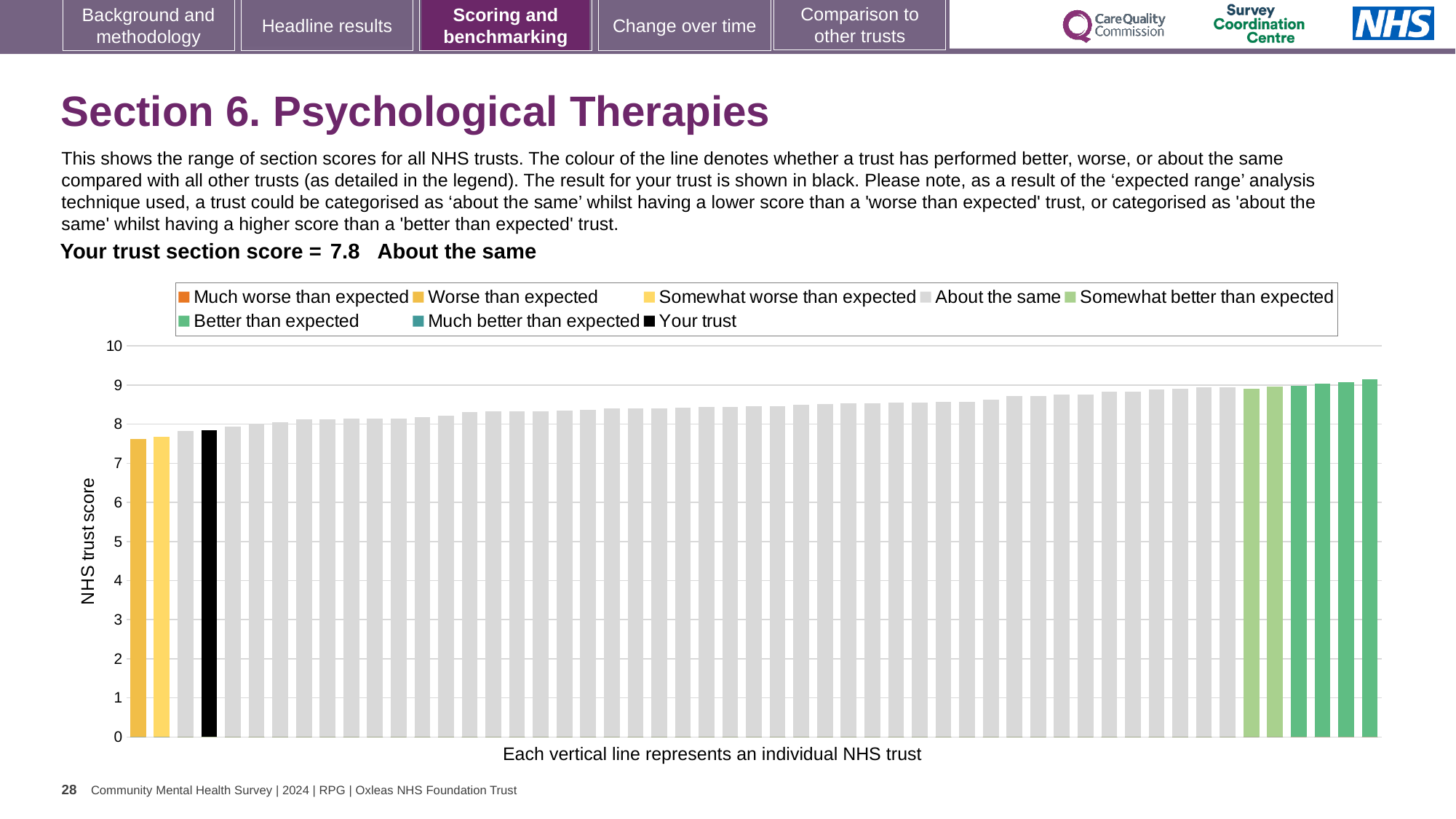
Is the value of the black bar representing your trust greater or less than 8? less What is the section score for your trust shown on the slide? 7.8 What kind of chart is shown on the slide? bar chart Do the bar values rise or fall from left to right along the x axis? rise What is the highest value shown on the y axis? 10 Is the value of the tallest bar (rightmost) greater or less than 9? greater Is the value of the shortest bar (leftmost) greater or less than 8? less Which category is your trust placed in for Section 6 Psychological Therapies? About the same How many entries does the chart legend list? 8 What colour is the bar representing your trust? black Is the leftmost bar taller or shorter than the rightmost bar? shorter What is the label on the y axis of the chart? NHS trust score